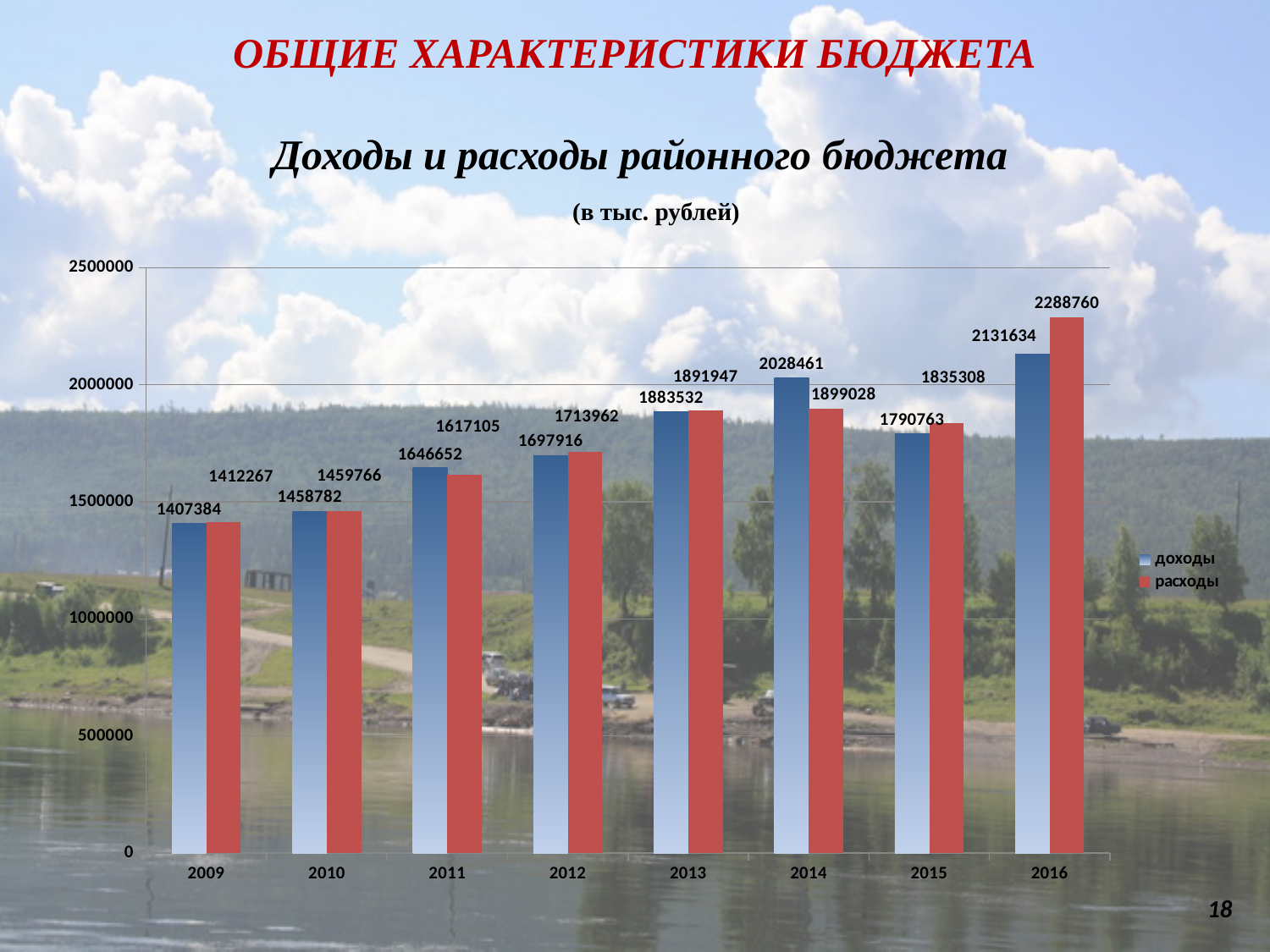
What is the difference between доходы and расходы in 2014? 129433 In which year are расходы lowest? 2009 What is the value of расходы for 2011? 1617105 How many years are shown on the x axis? 8 What is the value of расходы for 2016? 2288760 How many series does the legend list? 2 Is the value of доходы for 2009 greater or less than 1500000? less What is the difference between расходы and доходы in 2016? 157126 What kind of chart is shown on the slide? bar chart In which year are доходы highest? 2016 What is the value of доходы for 2014? 2028461 In 2014, which is larger: доходы or расходы? доходы